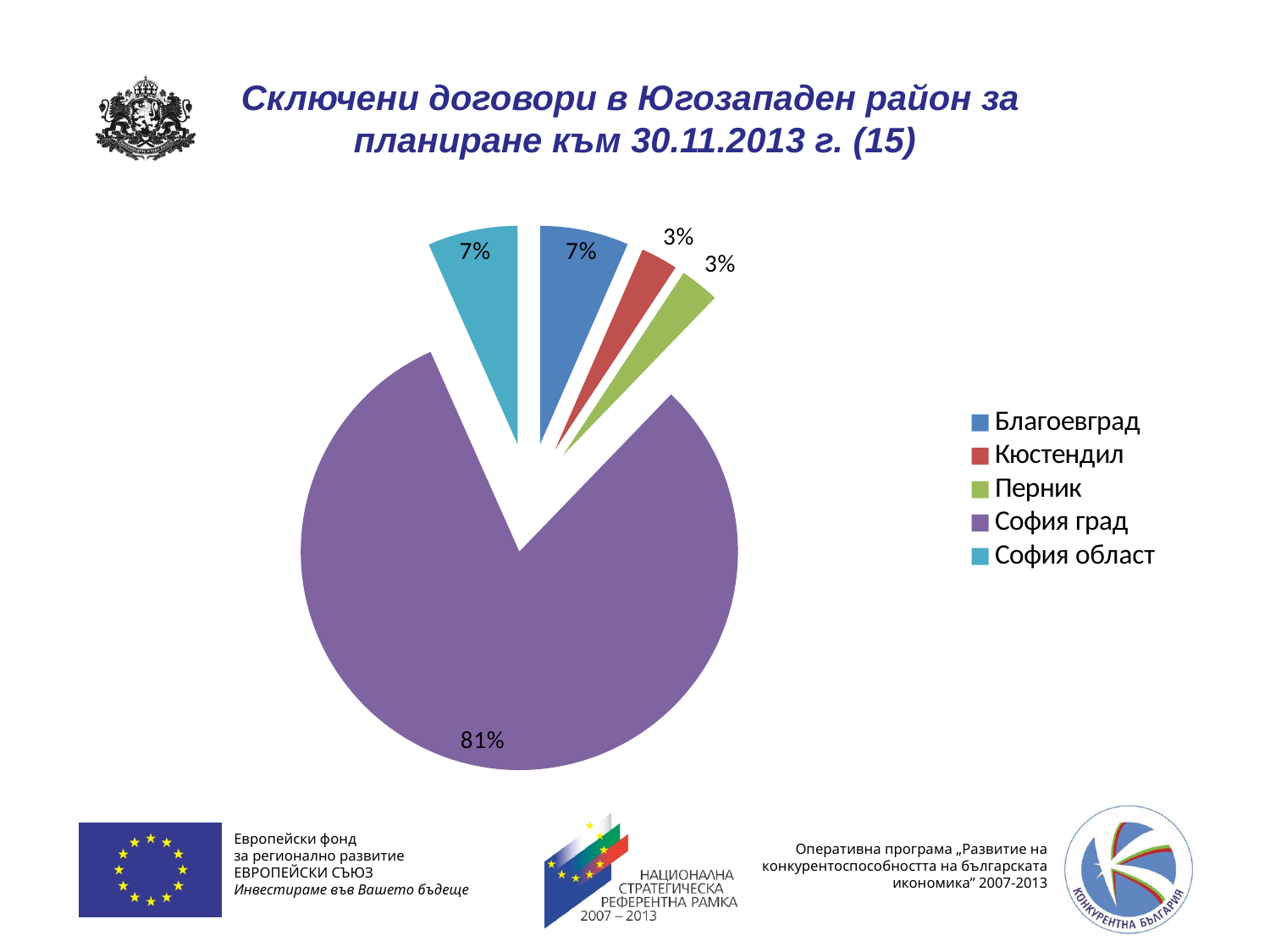
What is the value shown for Перник? 3% What kind of chart is shown on the slide? pie chart Which category has the largest slice of the pie? София град Which is larger, the slice for София град or the slice for Благоевград? София град What is the value shown for София област? 7% How many categories does the pie chart have? 5 Which is larger, the slice for Благоевград or the slice for Кюстендил? Благоевград What is the value shown for Кюстендил? 3% What is the difference in percentage points between София град and София област? 74 What is the value shown for Благоевград? 7% What share of the pie does София град hold? 81% What colour is the slice for София град? purple